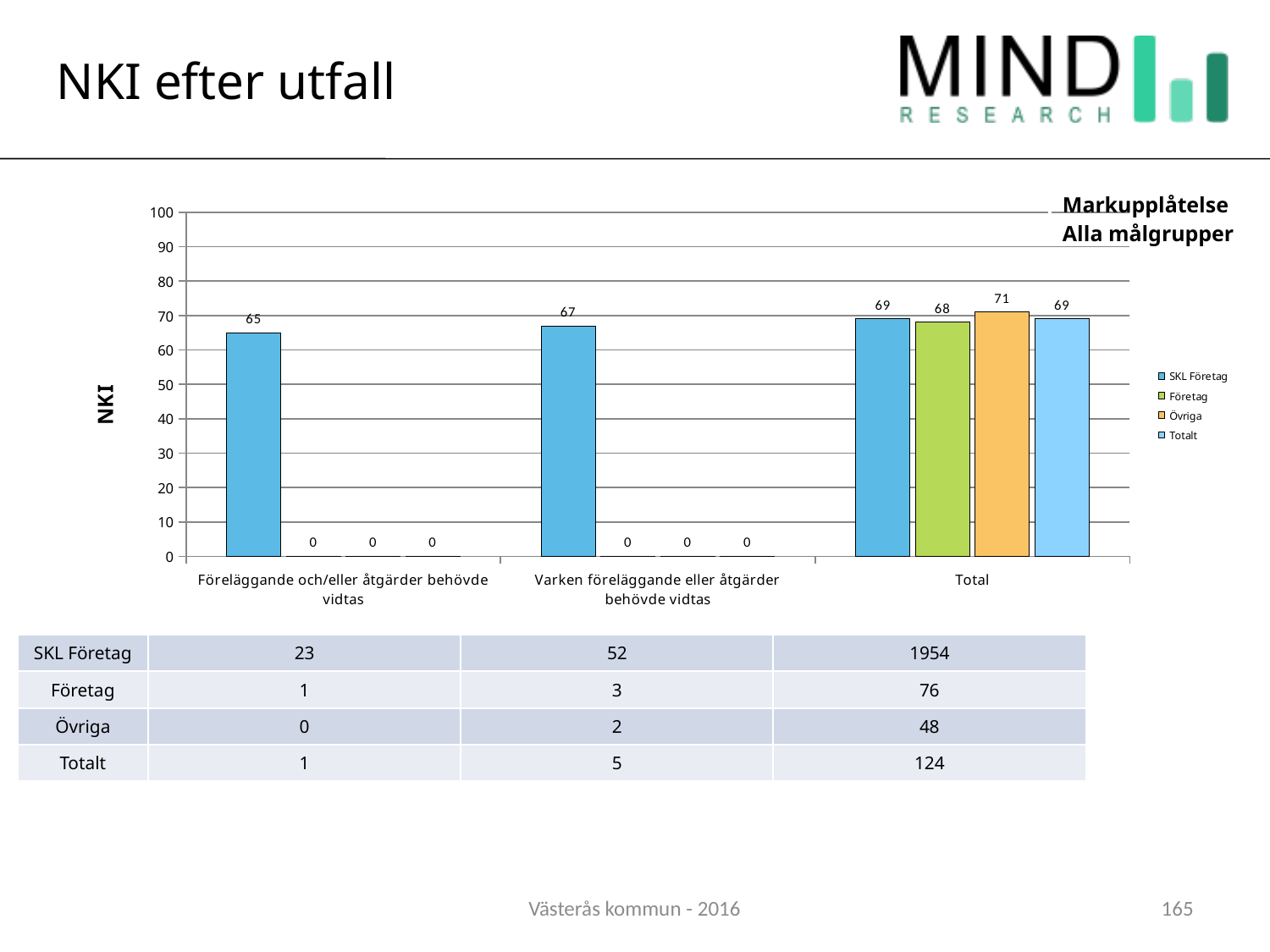
What is the NKI value for SKL Företag in the Total category? 69 Which is larger: the SKL Företag value for 'Föreläggande och/eller åtgärder behövde vidtas' or for 'Varken föreläggande eller åtgärder behövde vidtas'? Varken föreläggande eller åtgärder behövde vidtas Which series has the lowest NKI value in the Total category? Företag What is the NKI value for Övriga in the Total category? 71 What kind of chart is shown on the slide? Bar chart What is the NKI value for SKL Företag in the category 'Föreläggande och/eller åtgärder behövde vidtas'? 65 How many series does the legend list? 4 What is the label of the y axis? NKI What is the difference between the Övriga and Företag NKI values in the Total category? 3 Which series has the highest NKI value in the Total category? Övriga What is the NKI value for SKL Företag in the category 'Varken föreläggande eller åtgärder behövde vidtas'? 67 How many categories are shown on the x axis? 3